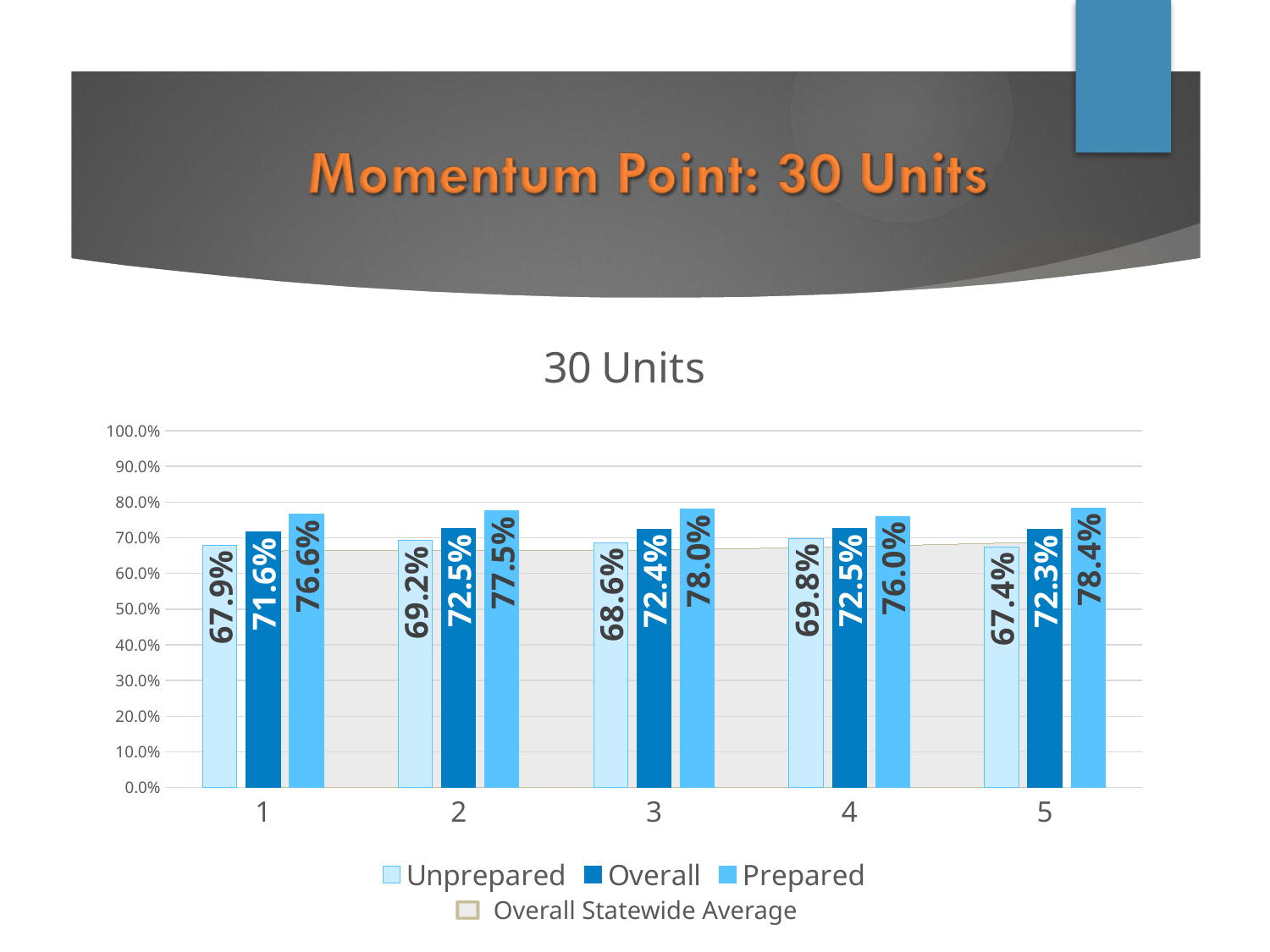
Which category has the lowest Unprepared value? 5 What is the title of the chart? 30 Units What is the difference between the Prepared and Unprepared values for category 2? 8.3% How many categories are shown on the x axis? 5 Which category has the highest Prepared value? 5 What is the Unprepared value for category 5? 67.4% What kind of chart is shown on the slide? combination bar and area chart What is the Overall value for category 1? 71.6% What is the Prepared value for category 3? 78.0% Which is larger, the Unprepared value for category 4 or the Unprepared value for category 1? Unprepared value for category 4 How many entries does the legend list? 4 Is the Overall Statewide Average line greater or less than 60.0%? greater